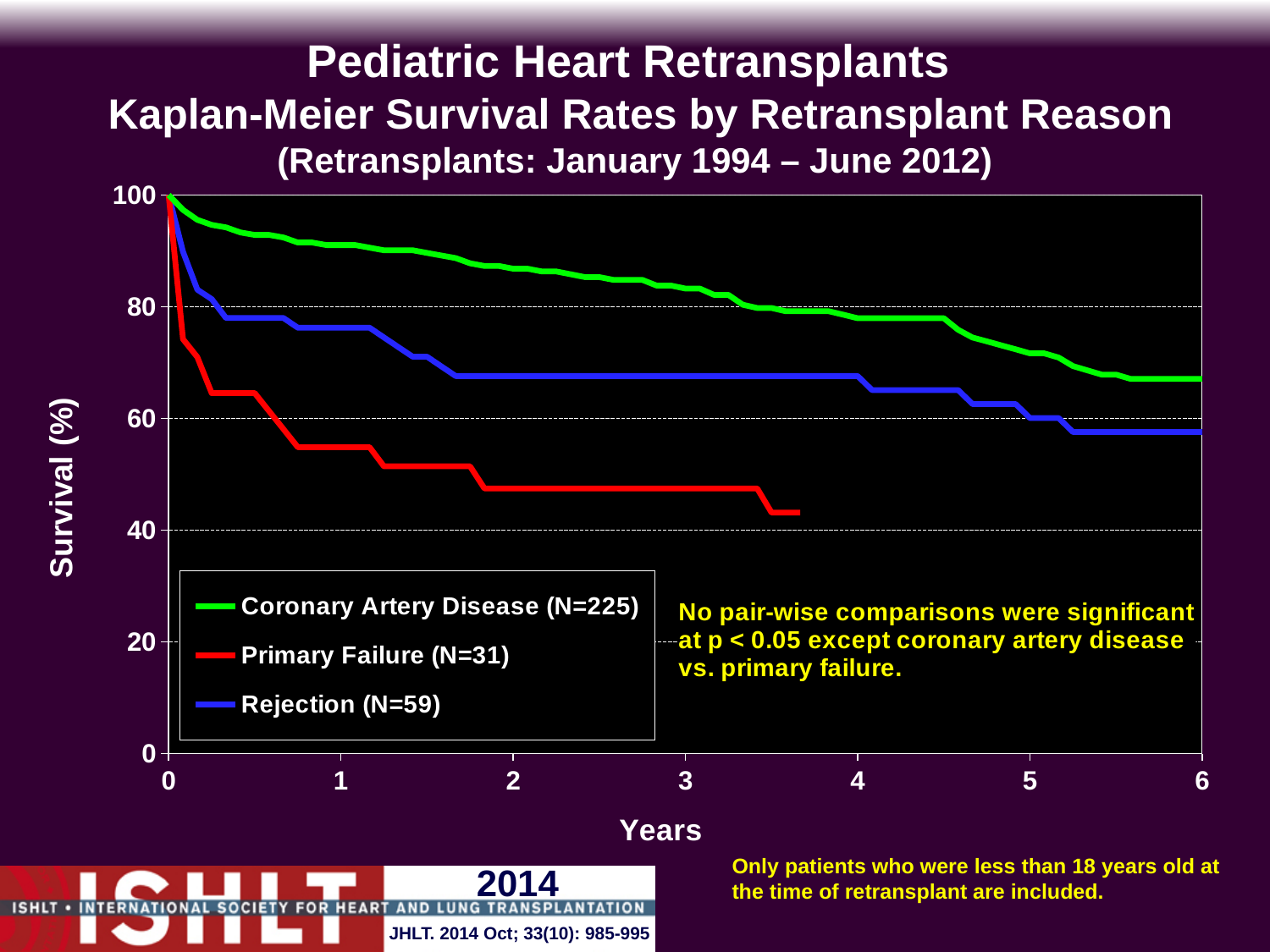
What kind of chart is shown on the slide? Line chart (Kaplan-Meier survival curve) At 3 years, which has higher survival: Coronary Artery Disease or Rejection? Coronary Artery Disease What is the N for the Primary Failure group shown in the legend? N=31 How many series does the legend list? 3 Which retransplant reason has the highest survival curve across the 6 years? Coronary Artery Disease What is the N for the Coronary Artery Disease group shown in the legend? N=225 Is the survival for Rejection at 6 years greater or less than 60%? less Which retransplant reason has the lowest survival curve? Primary Failure Is the survival for Coronary Artery Disease at 6 years greater or less than 60%? greater Is the survival for Coronary Artery Disease at 3 years greater or less than 80%? greater Do the survival curves rise or fall as years increase? Fall